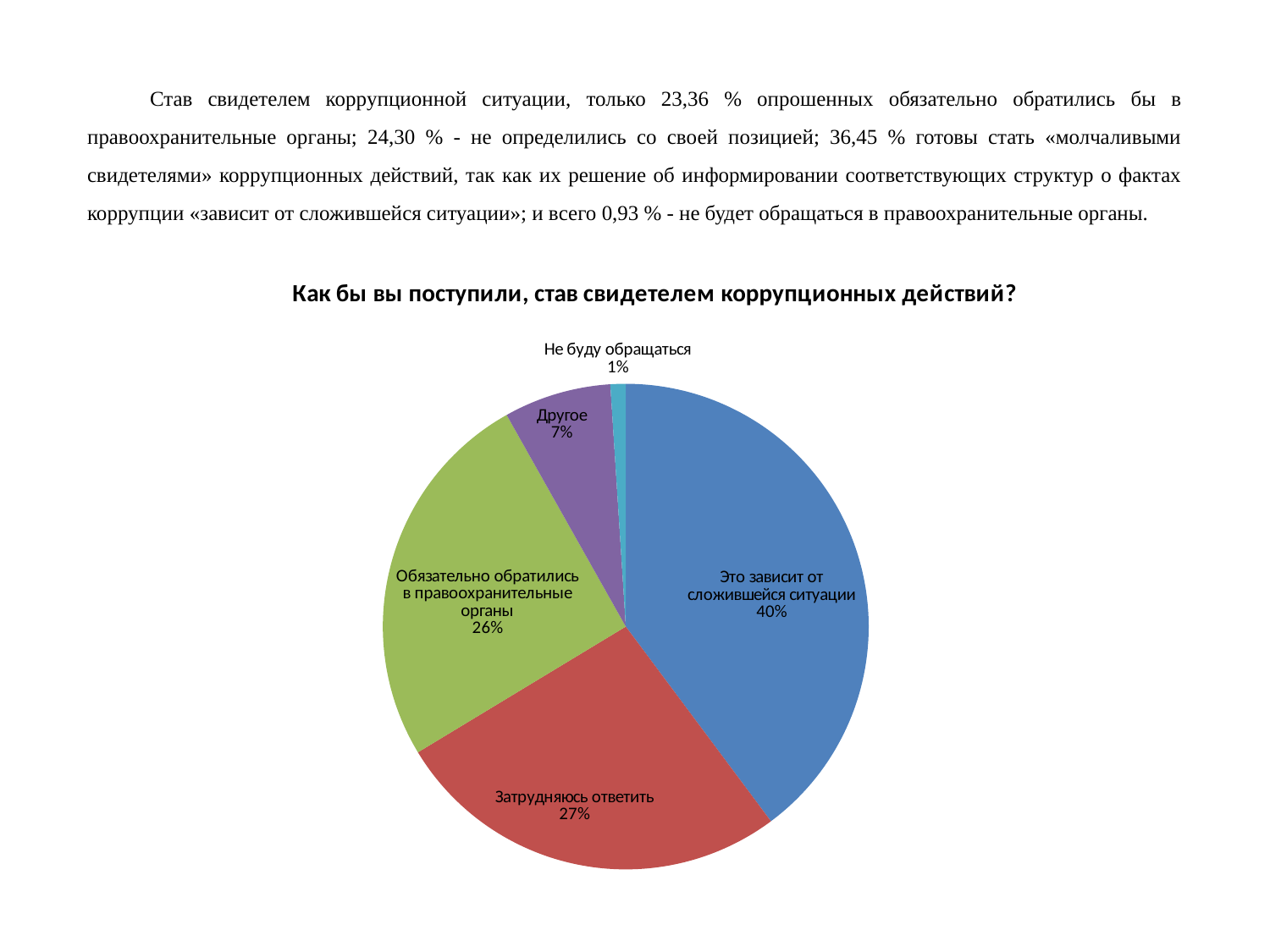
What share of the pie is labelled "Не буду обращаться"? 1% What share of the pie is labelled "Это зависит от сложившейся ситуации"? 40% What share of the pie is labelled "Обязательно обратились в правоохранительные органы"? 26% What share of the pie is labelled "Другое"? 7% Which is larger: the share for "Другое" or the share for "Обязательно обратились в правоохранительные органы"? Обязательно обратились в правоохранительные органы What share of the pie is labelled "Затрудняюсь ответить"? 27% Which slice of the pie is the smallest? Не буду обращаться What is the title of the chart? Как бы вы поступили, став свидетелем коррупционных действий? What is the difference in percentage points between "Это зависит от сложившейся ситуации" and "Затрудняюсь ответить"? 13 Which slice of the pie is the largest? Это зависит от сложившейся ситуации How many slices does the pie chart have? 5 What kind of chart is shown on the slide? pie chart